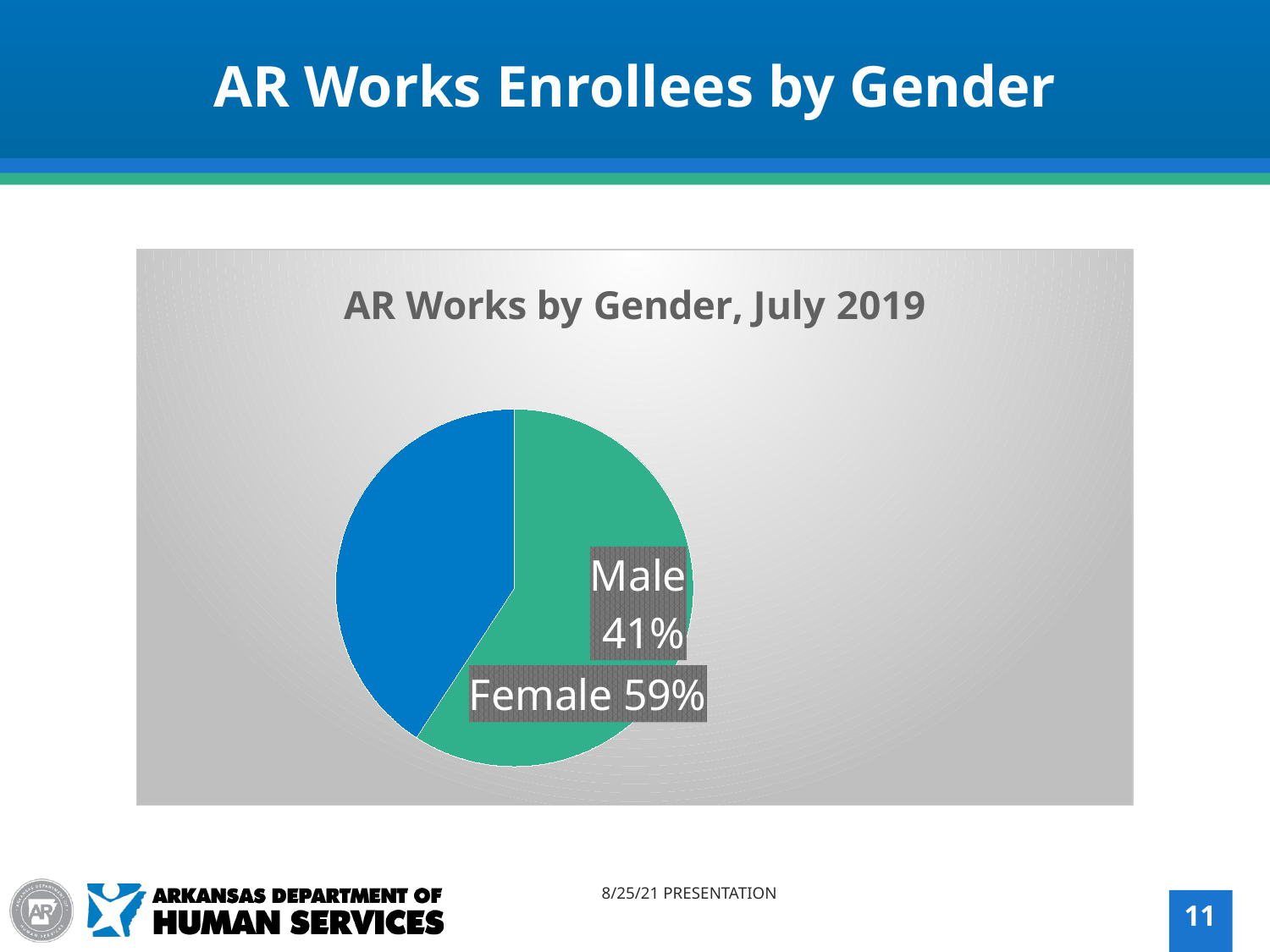
Which gender has the larger share of AR Works enrollees? Female Which gender has the smaller share of AR Works enrollees? Male Is the Male share greater or less than 50%? less How many slices does the pie chart have? 2 What kind of chart is shown on the slide? pie chart What is the title of the chart? AR Works by Gender, July 2019 What percentage of AR Works enrollees are male? 41% What percentage of AR Works enrollees are female? 59% By how many percentage points does the female share exceed the male share? 18 Is the share for Male larger or smaller than the share for Female? smaller What month and year does the chart title refer to? July 2019 What share of the pie does the Female slice represent? 59%